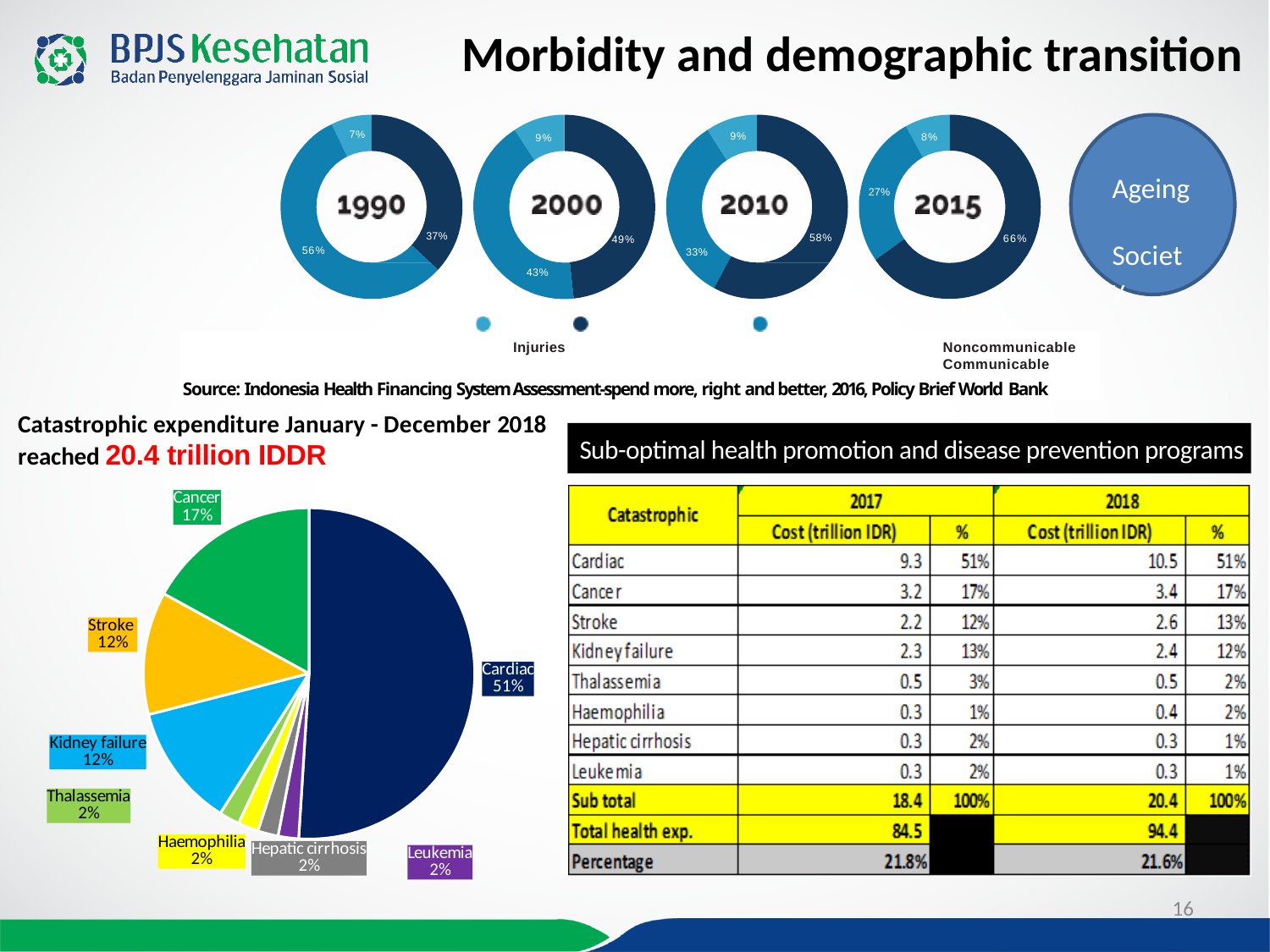
In the pie chart of catastrophic expenditure, how many percentage points larger is the Cardiac slice than the Cancer slice? 34% Across the donut charts from 1990 to 2015, does the dark navy (Noncommunicable) share rise or fall over time? Rise How many entries does the legend below the donut charts list? 3 In the pie chart of catastrophic expenditure, which category has the largest slice? Cardiac In the pie chart of catastrophic expenditure, what share is labelled for Cancer? 17% In the 2015 donut chart at the top of the slide, what percentage is shown for the largest (dark navy) segment? 66% In the pie chart of catastrophic expenditure, which slice is larger, Cancer or Stroke? Cancer What kind of chart is used to show the catastrophic expenditure breakdown at the bottom left of the slide? Pie chart In the pie chart of catastrophic expenditure, what share is labelled for Cardiac? 51% How many categories are shown in the pie chart of catastrophic expenditure? 8 In the 1990 donut chart at the top of the slide, what percentage is shown for the smallest (light blue) segment? 7% In the pie chart of catastrophic expenditure, what share is labelled for Kidney failure? 12%